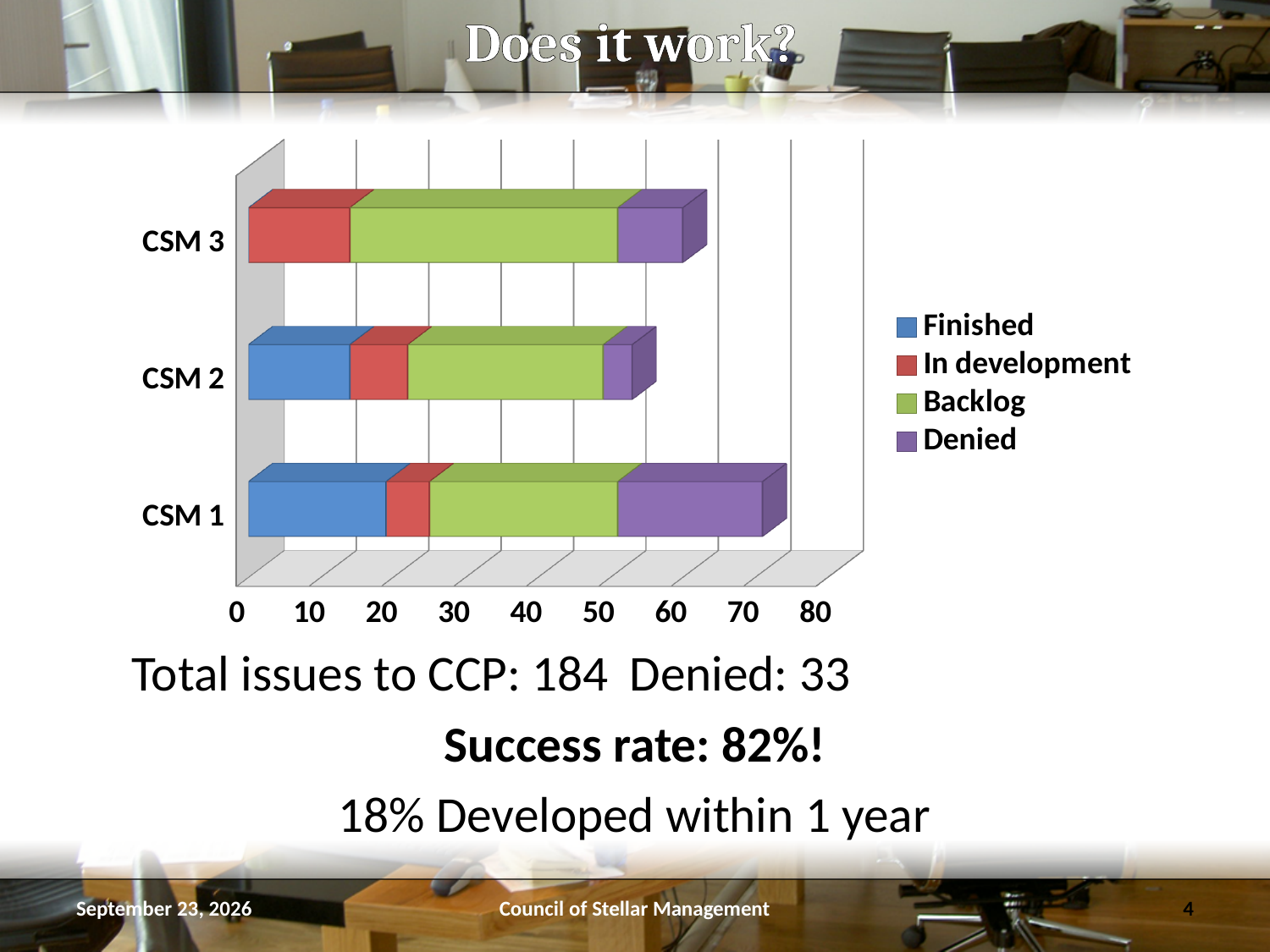
Which category has the largest Denied segment? CSM 1 Is the total bar length for CSM 2 greater or less than 60? less Is the total bar for CSM 1 longer or shorter than the total bar for CSM 2? longer How many categories are plotted on the chart? 3 Which category has the largest Backlog segment? CSM 3 What kind of chart is shown on the slide? stacked bar chart Which category has the shortest total bar? CSM 2 Is the total bar length for CSM 1 greater or less than 60? greater Which category has the longest total bar? CSM 1 Which category has no Finished segment? CSM 3 Which series is shown in green in the legend? Backlog How many series does the legend list? 4